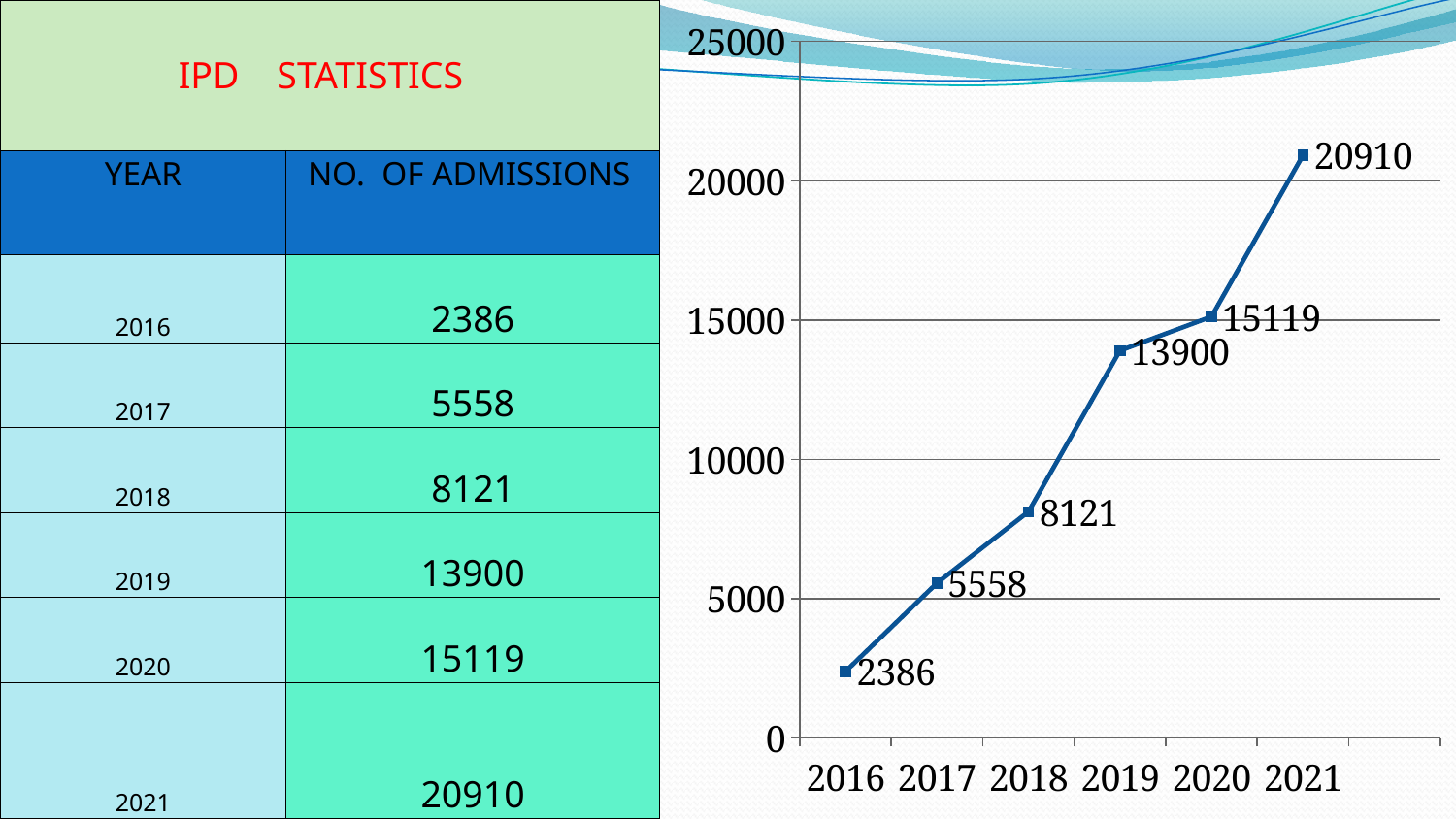
What value does the line chart show for 2021? 20910 What is the difference between the values for 2021 and 2020 on the line chart? 5791 Which year has the highest value on the line chart? 2021 What is the difference between the values for 2018 and 2017 on the line chart? 2563 What value does the line chart show for 2016? 2386 How many years are plotted on the line chart? 6 Is the value for 2020 on the line chart greater or less than 15000? greater Do the values on the line chart rise or fall from 2016 to 2021? rise What is the number of admissions plotted for 2019 on the line chart? 13900 Which is larger on the line chart, the value for 2019 or the value for 2018? 2019 Which year has the lowest value on the line chart? 2016 What kind of chart is shown on the right of the slide? line chart